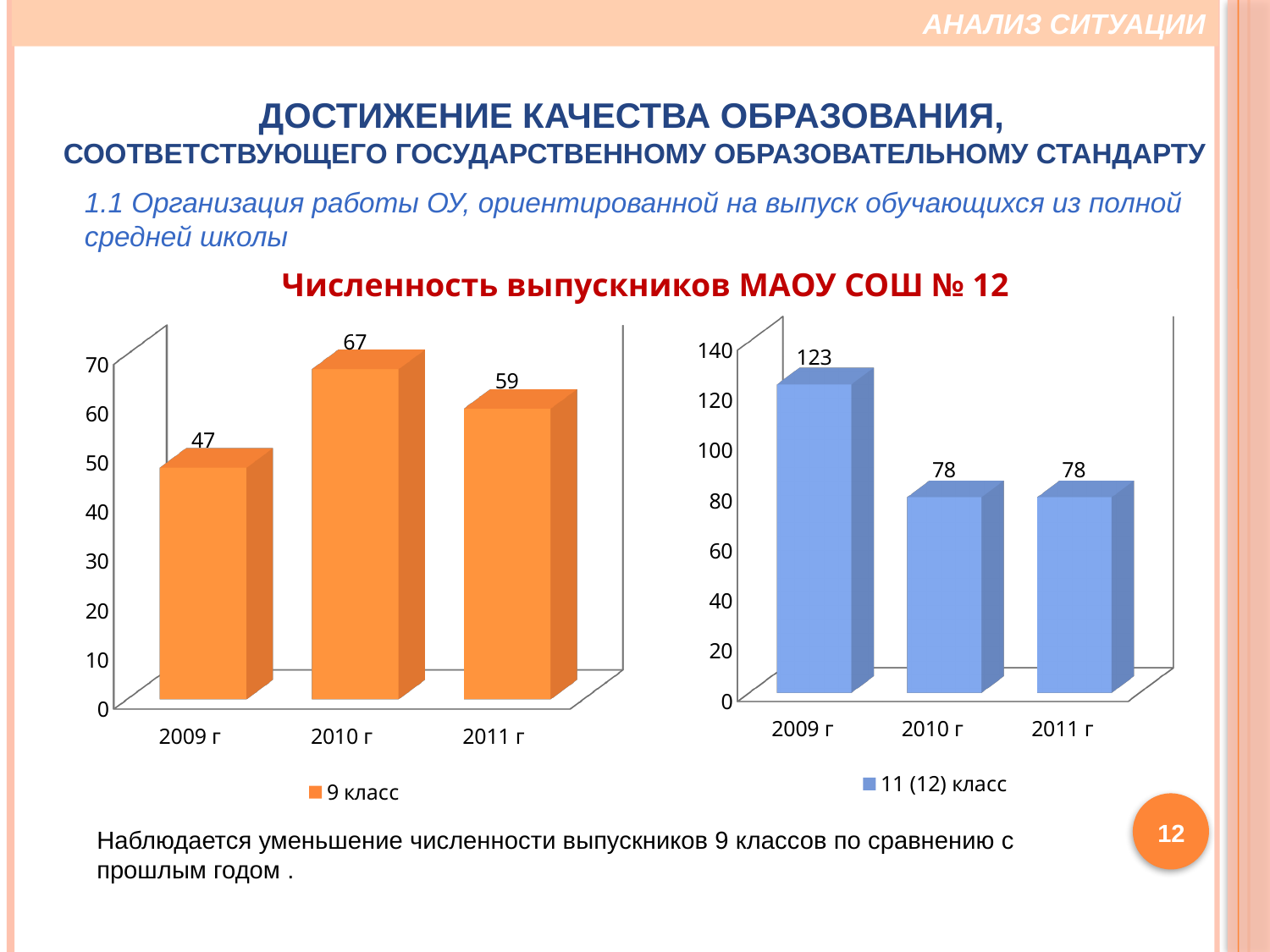
In the left chart (9 класс), what is the value for 2010 г? 67 In the right chart (11 (12) класс), which year has the highest value? 2009 г How many series does the legend of the right chart list? 1 In the right chart (11 (12) класс), what is the value for 2009 г? 123 In the left chart (9 класс), which year has the lowest value? 2009 г What type of chart is the left chart (9 класс)? bar chart In the right chart (11 (12) класс), is the value for 2011 г greater or less than 100? less In the left chart (9 класс), what is the difference between the values for 2010 г and 2011 г? 8 In the left chart (9 класс), which is larger: the value for 2009 г or the value for 2011 г? 2011 г How many years are shown on the x axis of the left chart (9 класс)? 3 In the right chart (11 (12) класс), what is the difference between the values for 2009 г and 2010 г? 45 What is the legend entry of the right chart? 11 (12) класс